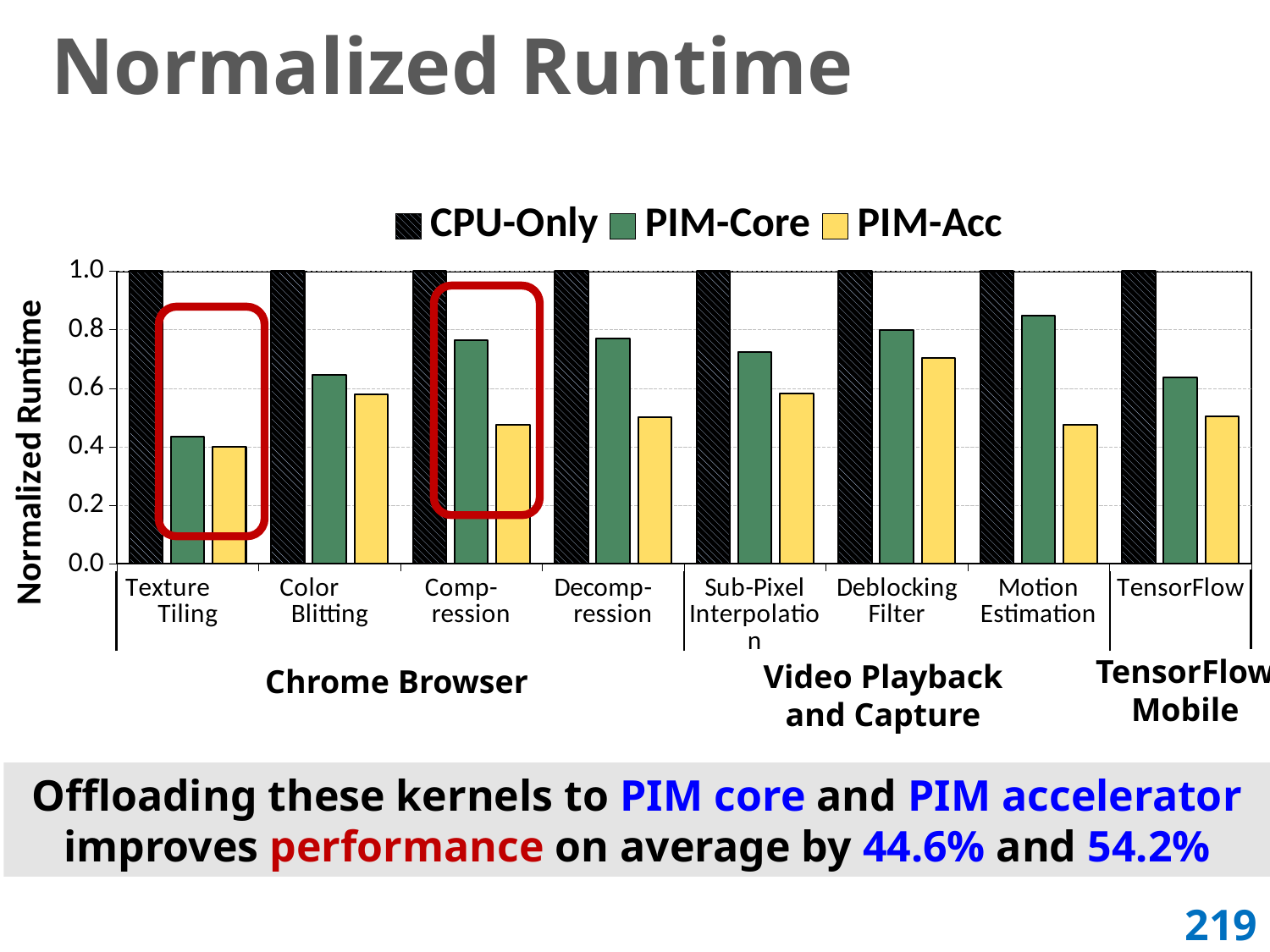
What kind of chart is shown on the slide? bar chart Is the PIM-Core value for Motion Estimation greater or less than 0.6? greater Which is larger: the PIM-Core value for Texture Tiling or the PIM-Core value for Color Blitting? Color Blitting What is the CPU-Only normalized runtime for Texture Tiling? 1.0 What is the label on the y axis of the chart? Normalized Runtime Which category has the lowest PIM-Acc normalized runtime? Texture Tiling How many kernel categories are plotted along the x axis? 8 Is the PIM-Acc value for Deblocking Filter greater or less than 0.6? greater Is the PIM-Core value for Texture Tiling greater or less than 0.6? less How many series does the legend list? 3 Which category has the highest PIM-Core normalized runtime? Motion Estimation For Compression, which is larger: the PIM-Core value or the PIM-Acc value? PIM-Core